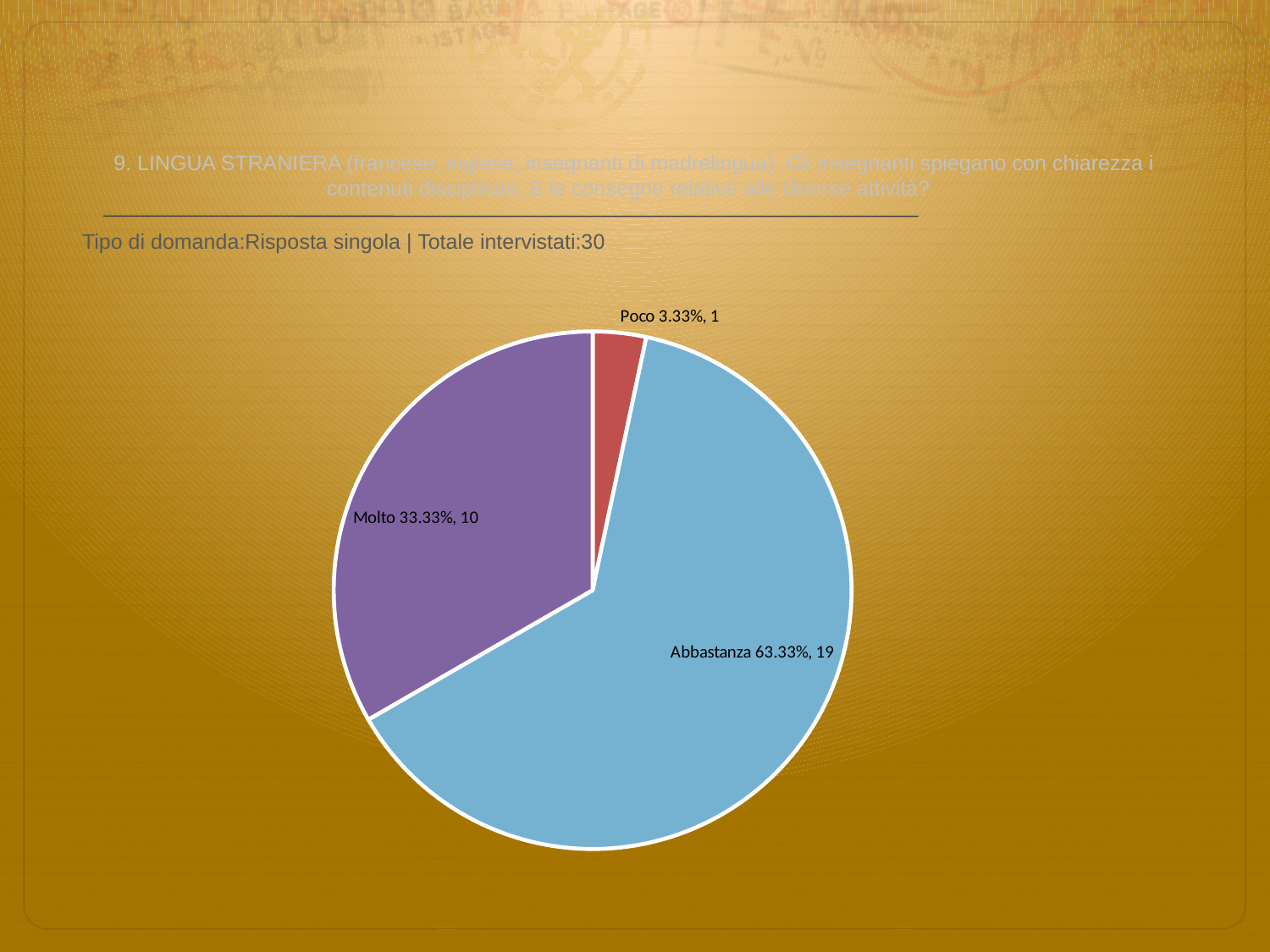
How many respondents answered Poco? 1 Which category has the largest slice? Abbastanza How many slices does the pie chart have? 3 What percentage share does the Molto slice have? 33.33% What is the difference in respondent count between Abbastanza and Molto? 9 What kind of chart is shown on the slide? pie chart Which category has the smallest slice? Poco What percentage share does the Poco slice have? 3.33% How many respondents answered Molto? 10 Which is larger, the Molto slice or the Poco slice? Molto How many respondents answered Abbastanza? 19 What percentage share does the Abbastanza slice have? 63.33%